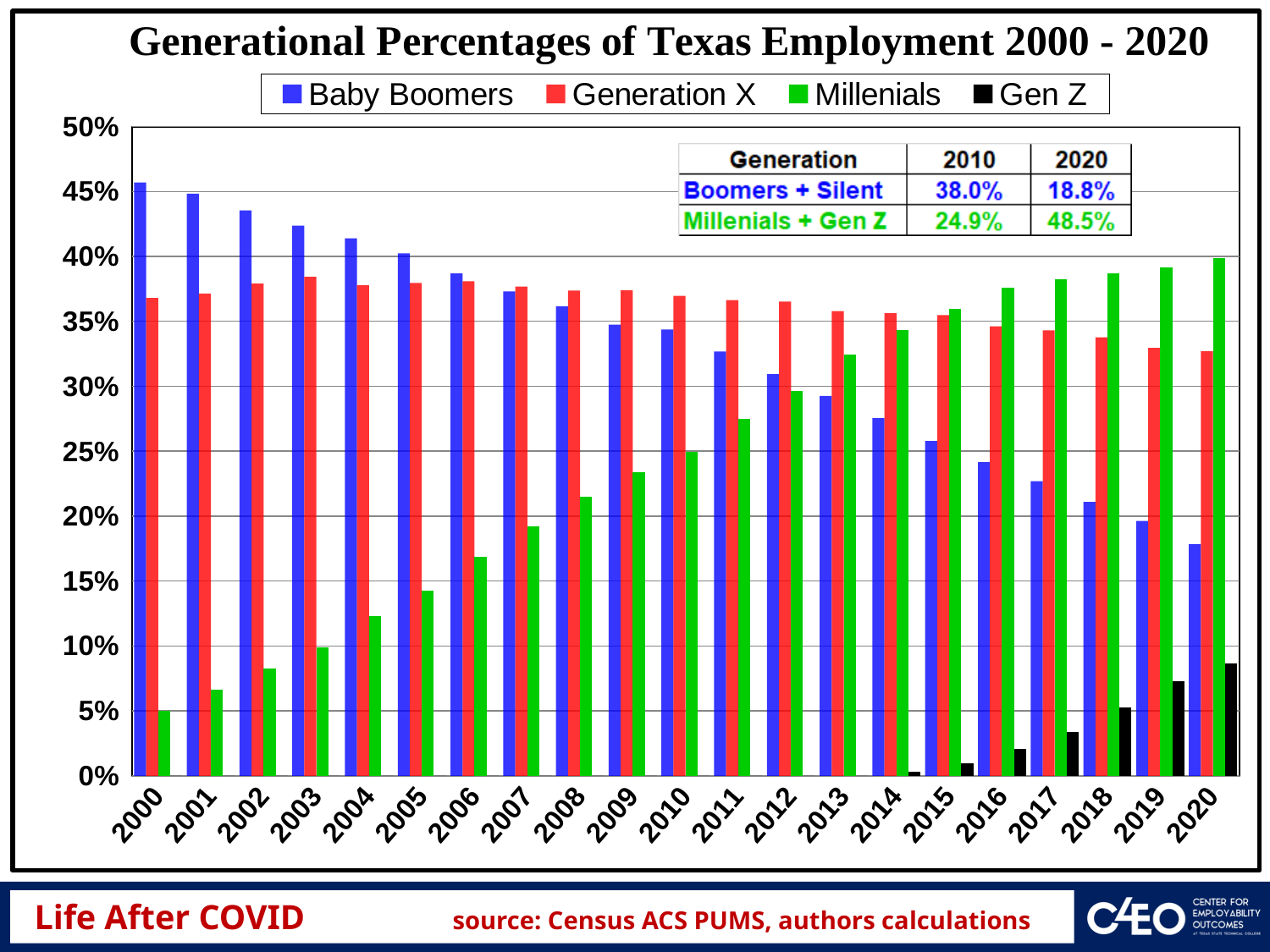
Is the Baby Boomers value for 2000 greater or less than 40%? greater Is the Millenials value for 2020 greater or less than 35%? greater According to the inset table, by how much did the Boomers + Silent percentage fall from 2010 to 2020? 19.2% According to the inset table, what was the Boomers + Silent percentage in 2010? 38.0% How many years are shown along the x axis? 21 Is the Gen Z value for 2020 greater or less than 10%? less Which series has the lowest value in 2020? Gen Z How many series does the legend list? 4 Do the Baby Boomers values rise or fall from 2000 to 2020? fall What kind of chart is shown on the slide? bar chart Do the Millenials values rise or fall from 2000 to 2020? rise According to the inset table, what was the Millenials + Gen Z percentage in 2020? 48.5%